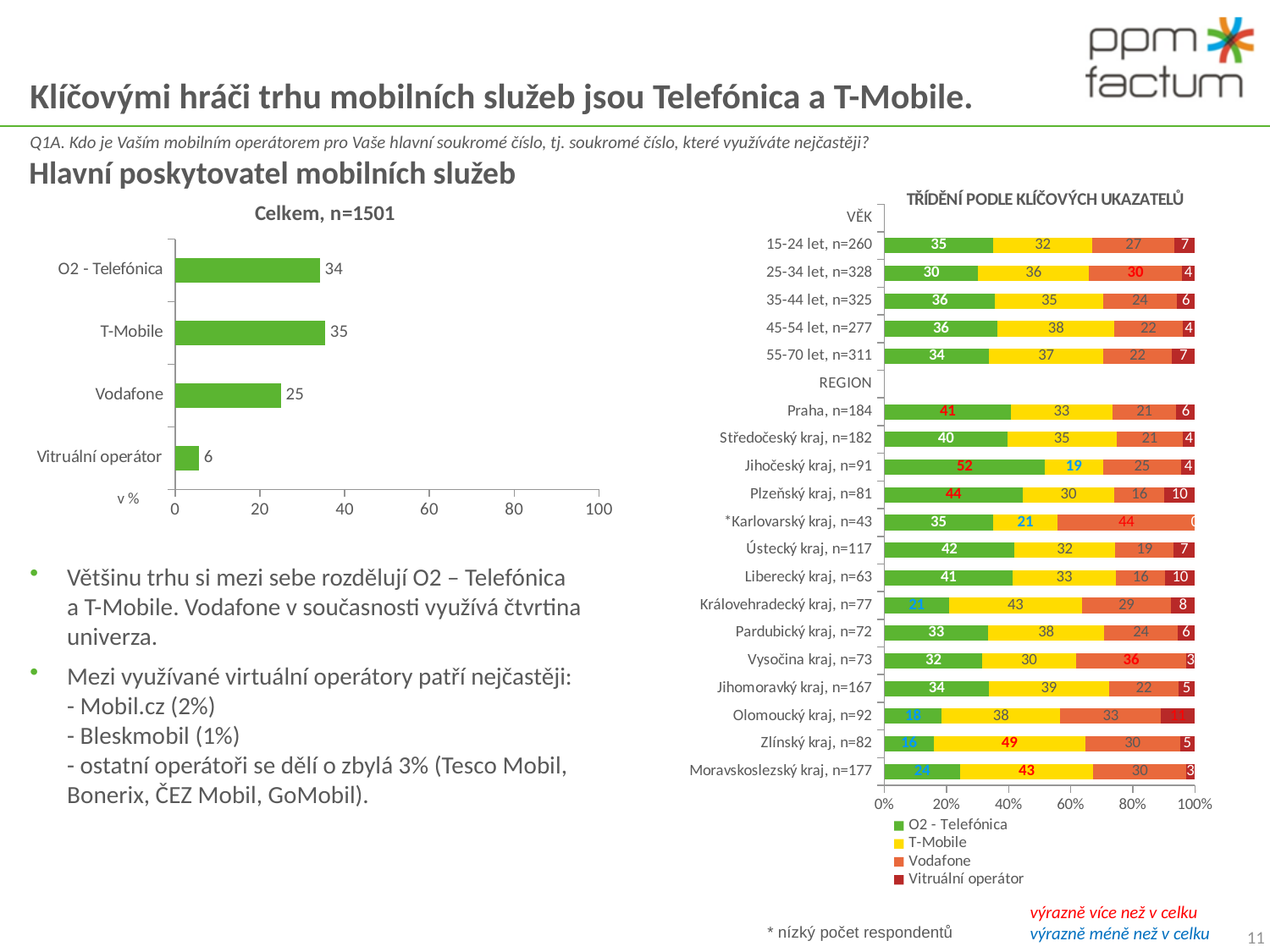
In the 'Celkem, n=1501' chart, what is the value for T-Mobile? 35 In the 'TŘÍDĚNÍ PODLE KLÍČOVÝCH UKAZATELŮ' chart, what is the Vodafone value for *Karlovarský kraj, n=43? 44 In the 'TŘÍDĚNÍ PODLE KLÍČOVÝCH UKAZATELŮ' chart, which is larger: the O2 - Telefónica value for Praha, n=184 or for Královehradecký kraj, n=77? Praha, n=184 In the 'Celkem, n=1501' chart, what is the difference between the values for T-Mobile and Vodafone? 10 How many series does the legend of the 'TŘÍDĚNÍ PODLE KLÍČOVÝCH UKAZATELŮ' chart list? 4 In the 'Celkem, n=1501' chart, which category has the lowest value? Vitruální operátor In the 'TŘÍDĚNÍ PODLE KLÍČOVÝCH UKAZATELŮ' chart, what is the T-Mobile value for Zlínský kraj, n=82? 49 In the 'TŘÍDĚNÍ PODLE KLÍČOVÝCH UKAZATELŮ' chart, what is the O2 - Telefónica value for Jihočeský kraj, n=91? 52 What kind of chart is the 'Celkem, n=1501' chart? bar chart In the 'Celkem, n=1501' chart, is the value for O2 - Telefónica greater or less than 40? less In the 'Celkem, n=1501' chart, how many categories are shown? 4 In the 'Celkem, n=1501' chart, what is the value for Vodafone? 25